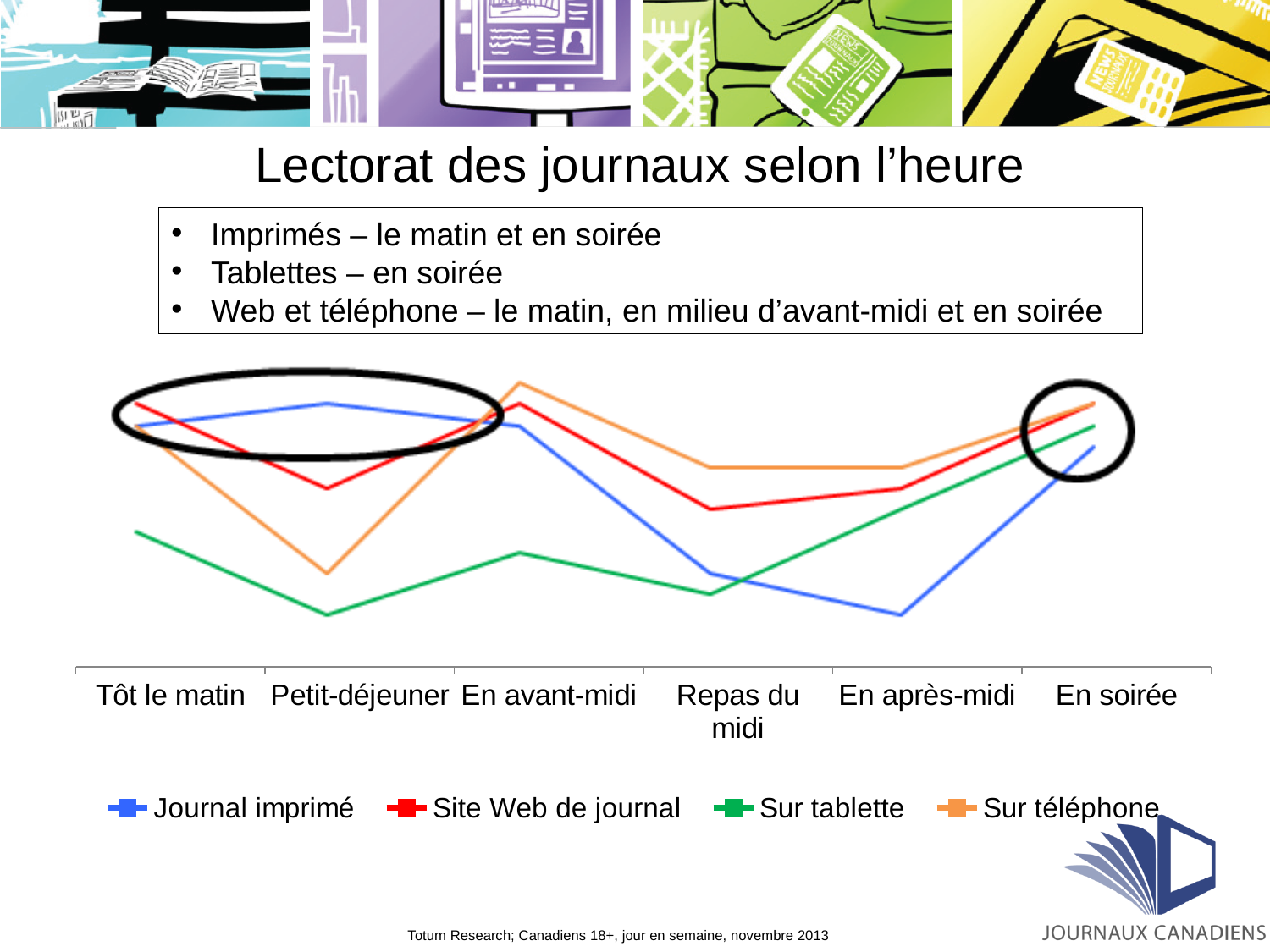
At which time of day is the 'Sur tablette' line at its highest? En soirée Does the 'Journal imprimé' line rise or fall from 'Petit-déjeuner' to 'En après-midi'? fall At which time of day is the 'Journal imprimé' line at its lowest? En après-midi What kind of chart is shown on the slide? line chart What is the title of the chart on the slide? Lectorat des journaux selon l'heure At which time of day is the 'Sur tablette' line at its lowest? Petit-déjeuner How many series does the chart's legend list? 4 At 'Petit-déjeuner', which is higher: 'Journal imprimé' or 'Sur tablette'? Journal imprimé At which time of day is the 'Sur téléphone' line at its lowest? Petit-déjeuner How many time-of-day categories are shown on the x axis of the chart? 6 At 'En après-midi', which is higher: 'Sur téléphone' or 'Journal imprimé'? Sur téléphone Which colour represents the 'Sur tablette' series in the chart? green